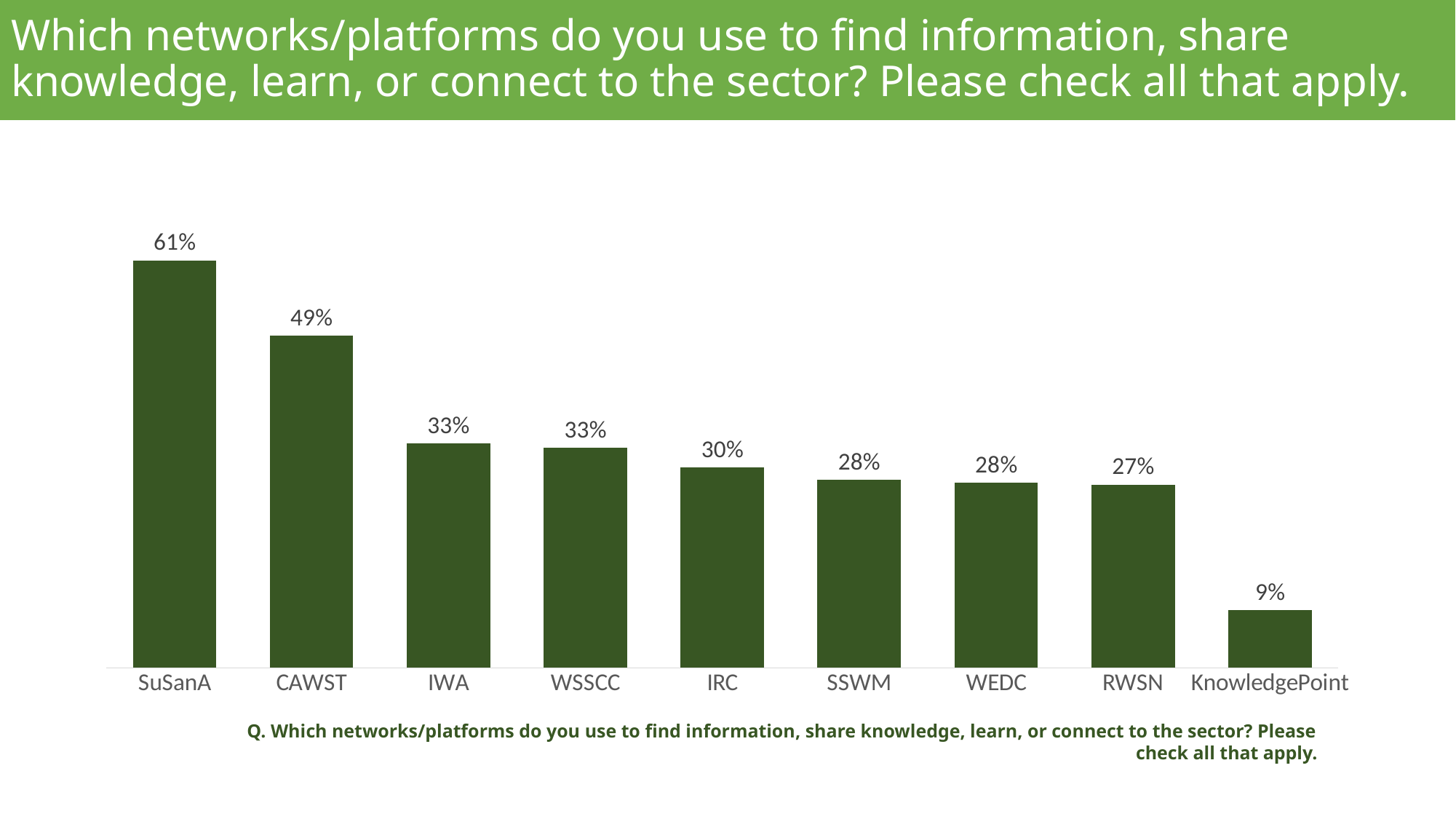
What percentage of respondents use SuSanA? 61% What percentage is shown for IRC? 30% Which network/platform has the lowest percentage? KnowledgePoint How many networks/platforms are shown on the chart? 9 What is the difference between the values for SuSanA and CAWST? 12% What is the value shown for CAWST? 49% What kind of chart is shown on the slide? Bar chart Which has a larger value, CAWST or WSSCC? CAWST What is the difference between the values for RWSN and KnowledgePoint? 18% Which network/platform has the highest percentage? SuSanA Do the values rise or fall from left to right across the chart? Fall What is the value for KnowledgePoint? 9%